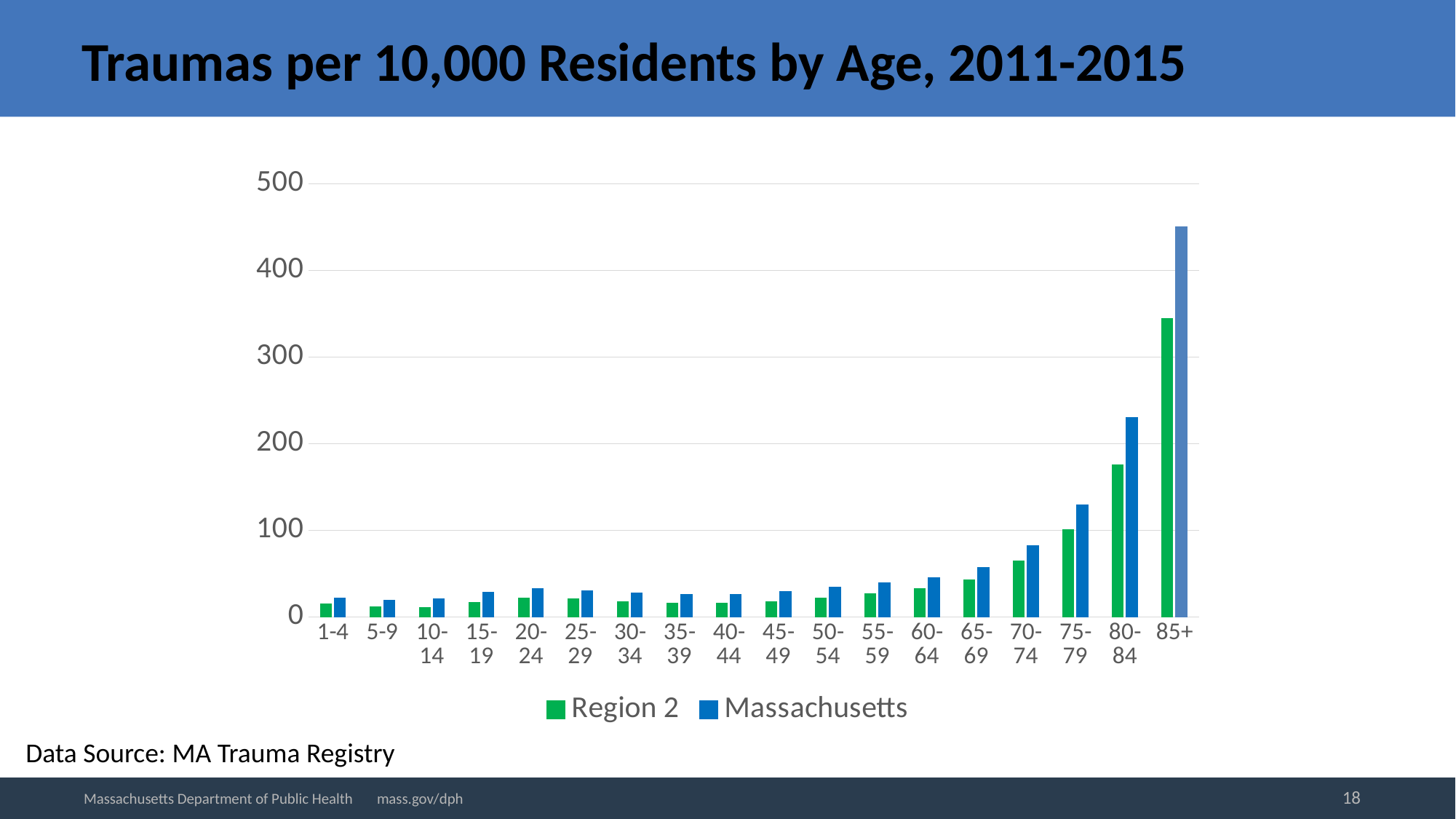
Which age group has the highest value for Region 2? 85+ Do the values generally rise or fall as age increases along the x axis? Rise Is the Massachusetts value for the 80-84 age group greater or less than 200? greater Is the Region 2 value for the 70-74 age group greater or less than 100? less Which is larger: the Region 2 value for 85+ or the Massachusetts value for 80-84? Region 2 value for 85+ For the 85+ age group, which is larger: Region 2 or Massachusetts? Massachusetts Is the Region 2 value for the 85+ age group greater or less than 400? less Which age group has the highest value for Massachusetts? 85+ How many series does the legend list? 2 What kind of chart is shown on the slide? Bar chart How many age groups are shown on the x axis? 18